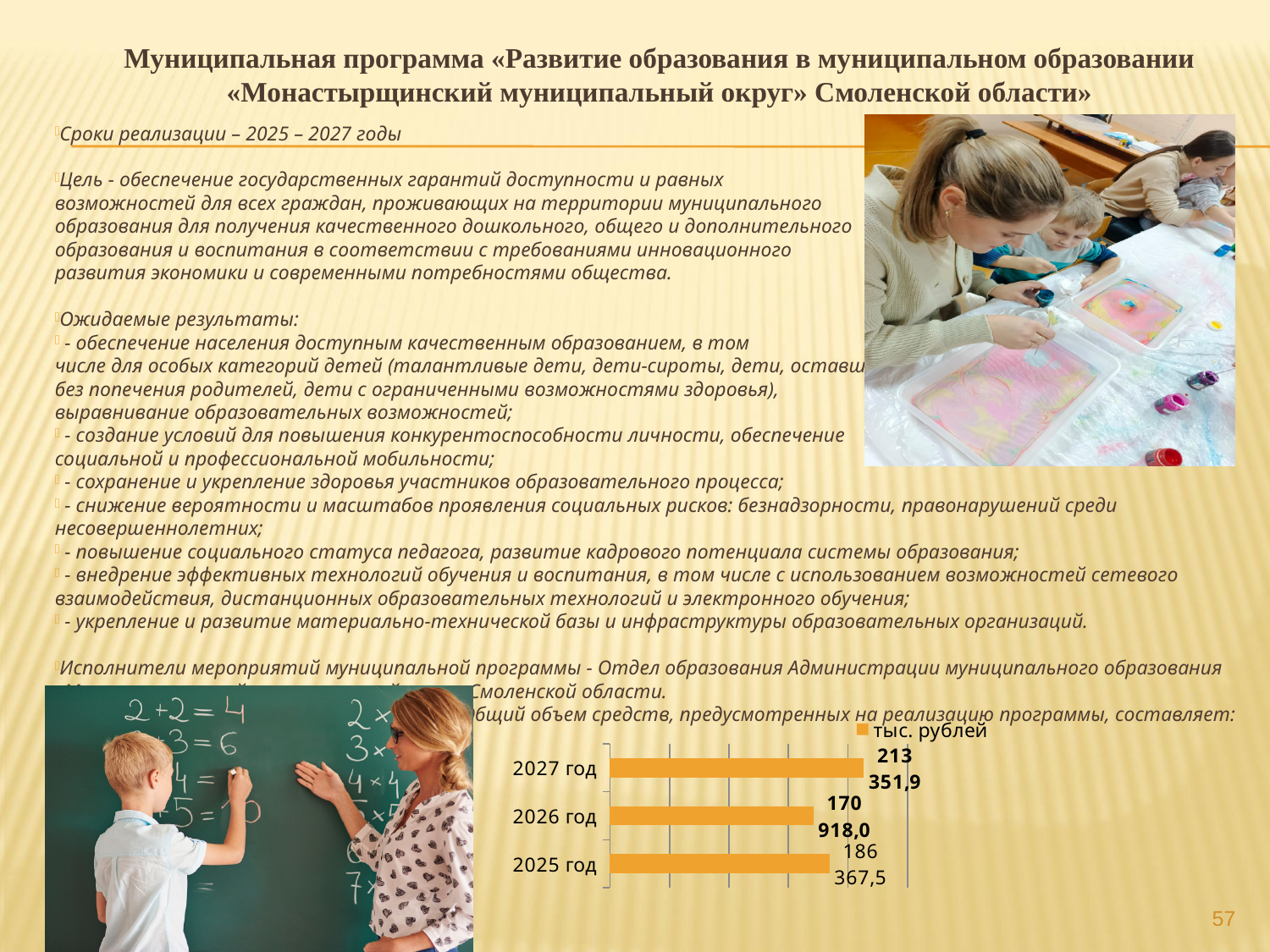
What is the value for 2026 год in the chart? 170 918,0 What is the legend entry of the chart? тыс. рублей Which year has the lowest value in the chart? 2026 год What is the value for 2027 год in the chart? 213 351,9 Which year has the highest value in the chart? 2027 год What type of chart is shown at the bottom of the slide? bar chart What is the value for 2025 год in the chart? 186 367,5 Which is larger in the chart, the value for 2025 год or for 2026 год? 2025 год How many categories (years) are shown in the chart? 3 How many series does the chart legend list? 1 What is the difference between the values for 2027 год and 2025 год in the chart? 26 984,4 What is the difference between the values for 2027 год and 2026 год in the chart? 42 433,9